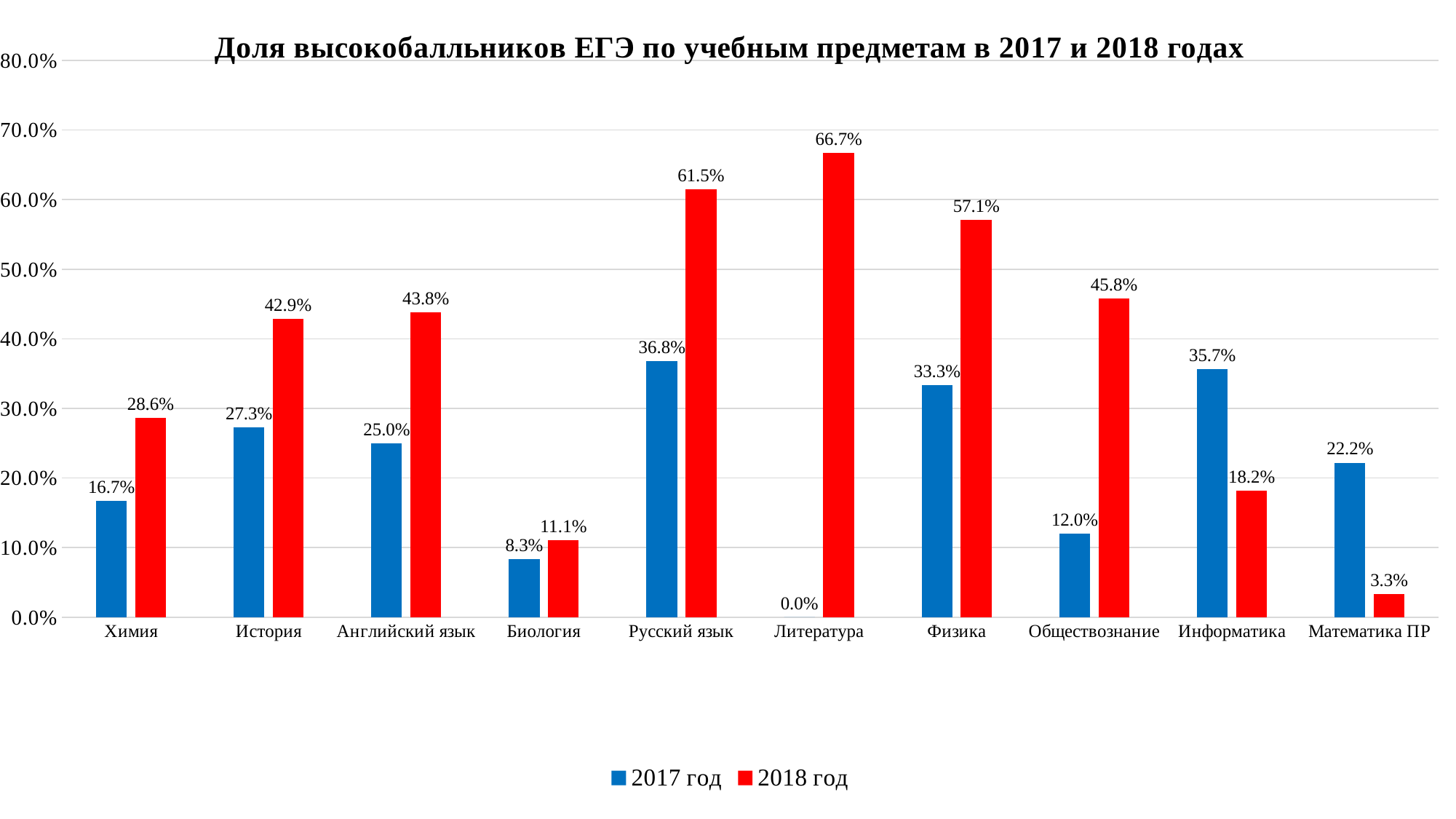
What type of chart is shown on the slide? Bar chart What colour are the bars for the 2018 год series? Red What is the value for Информатика in 2017 год? 35.7% Which subject has the lowest value in the 2017 год series? Литература Which subject has the lowest value in the 2018 год series? Математика ПР What is the value for Биология in 2018 год? 11.1% How many subject categories are shown on the x axis? 10 What is the value for Литература in 2018 год? 66.7% How many series does the legend list? 2 Which subject has the highest value in the 2018 год series? Литература What is the difference between the 2018 год and 2017 год values for Русский язык? 24.7% Which is larger for Информатика: the 2017 год value or the 2018 год value? 2017 год